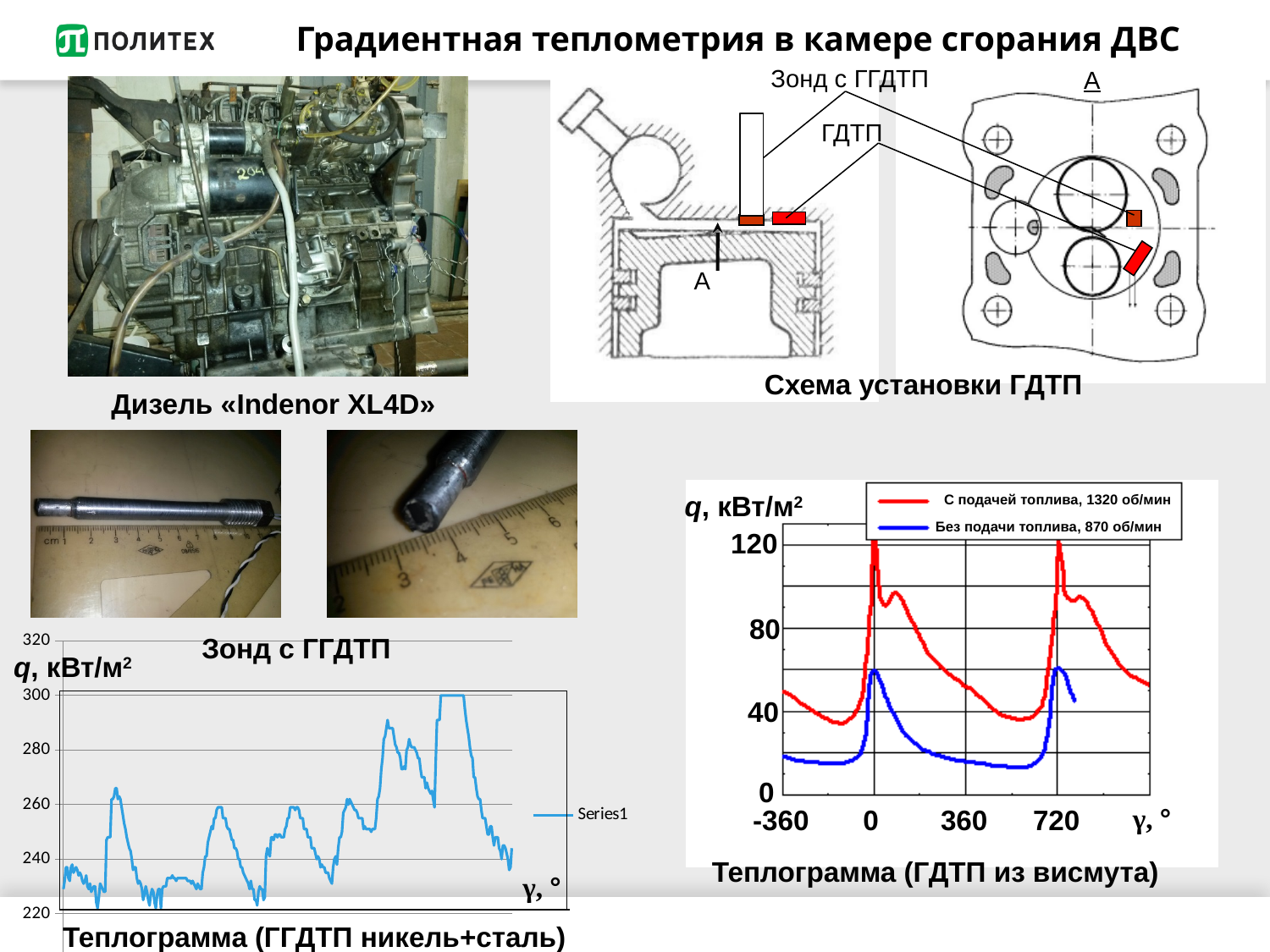
In the bottom-right chart «Теплограмма (ГДТП из висмута)», is the peak value of the «Без подачи топлива, 870 об/мин» series greater or less than 80? less In the bottom-right chart «Теплограмма (ГДТП из висмута)», which series reaches the higher peak value: «С подачей топлива, 1320 об/мин» or «Без подачи топлива, 870 об/мин»? С подачей топлива, 1320 об/мин How many series does the legend of the bottom-right chart «Теплограмма (ГДТП из висмута)» list? 2 What is the label of the x axis of the bottom-right chart «Теплограмма (ГДТП из висмута)»? γ, ° How many series does the legend of the bottom-left chart «Теплограмма (ГГДТП никель+сталь)» list? 1 In the bottom-right chart «Теплограмма (ГДТП из висмута)», which series is drawn in red? С подачей топлива, 1320 об/мин What kind of chart is the bottom-left chart titled «Теплограмма (ГГДТП никель+сталь)»? line chart In the bottom-right chart «Теплограмма (ГДТП из висмута)», is the peak value of the «С подачей топлива, 1320 об/мин» series greater or less than 80? greater In the bottom-right chart «Теплограмма (ГДТП из висмута)», is the value of the «Без подачи топлива, 870 об/мин» series at γ = -360° greater or less than 40? less What kind of chart is the bottom-right chart titled «Теплограмма (ГДТП из висмута)»? line chart